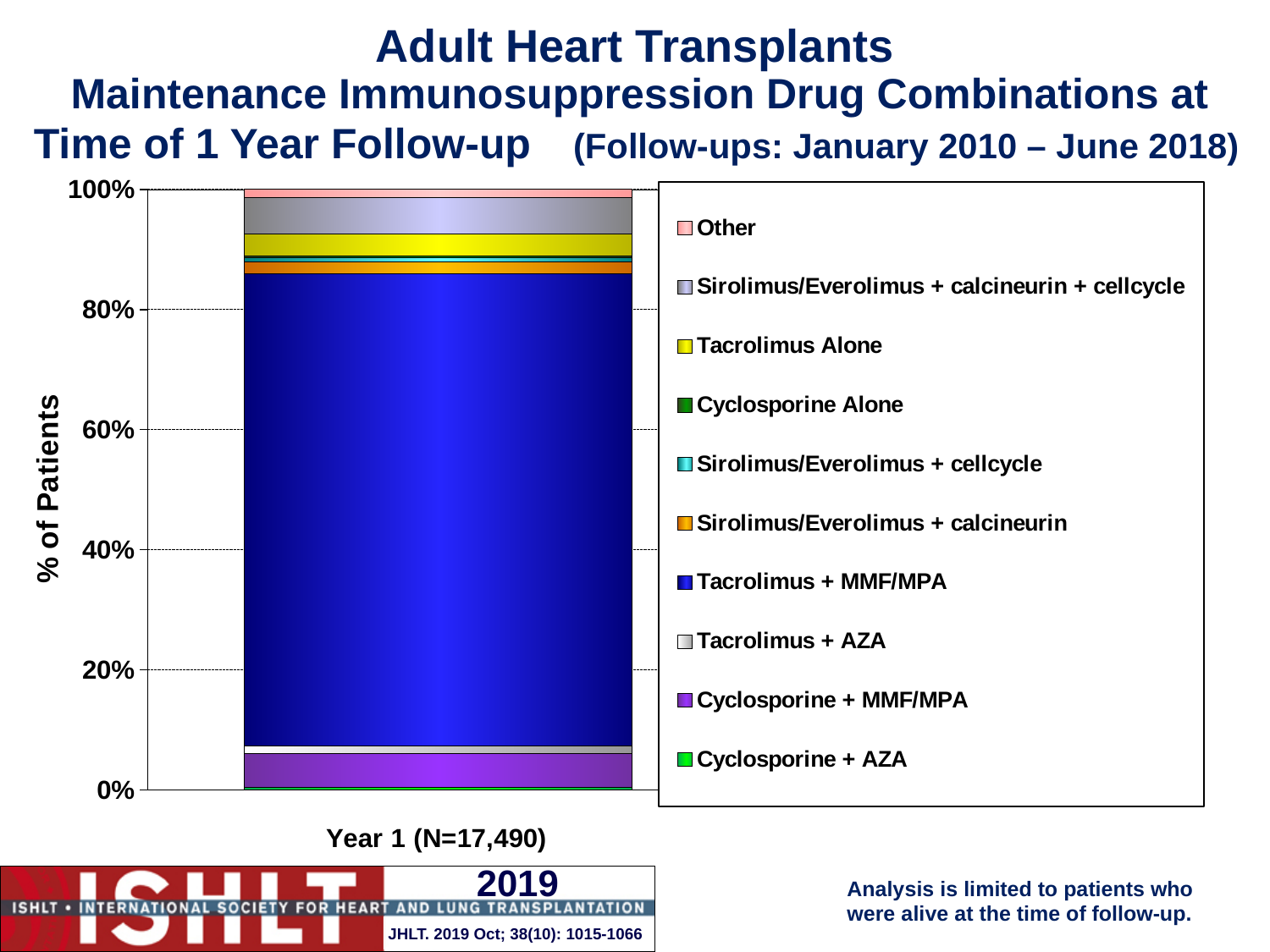
What kind of chart is shown on the slide? Stacked bar chart Is the value for Tacrolimus + MMF/MPA greater or less than 60%? greater How many bars (categories) are plotted on the x axis? 1 Which is larger, the share for Tacrolimus Alone or the share for Cyclosporine Alone? Tacrolimus Alone Which drug combination accounts for the largest share of patients at Year 1? Tacrolimus + MMF/MPA What is the label of the y axis? % of Patients Is the value for Cyclosporine + MMF/MPA greater or less than 20%? less What is the label of the single bar on the x axis? Year 1 (N=17,490) Is the value for Other greater or less than 20%? less How many series does the legend list? 10 Which is larger, the share for Tacrolimus + MMF/MPA or the share for Cyclosporine + MMF/MPA? Tacrolimus + MMF/MPA